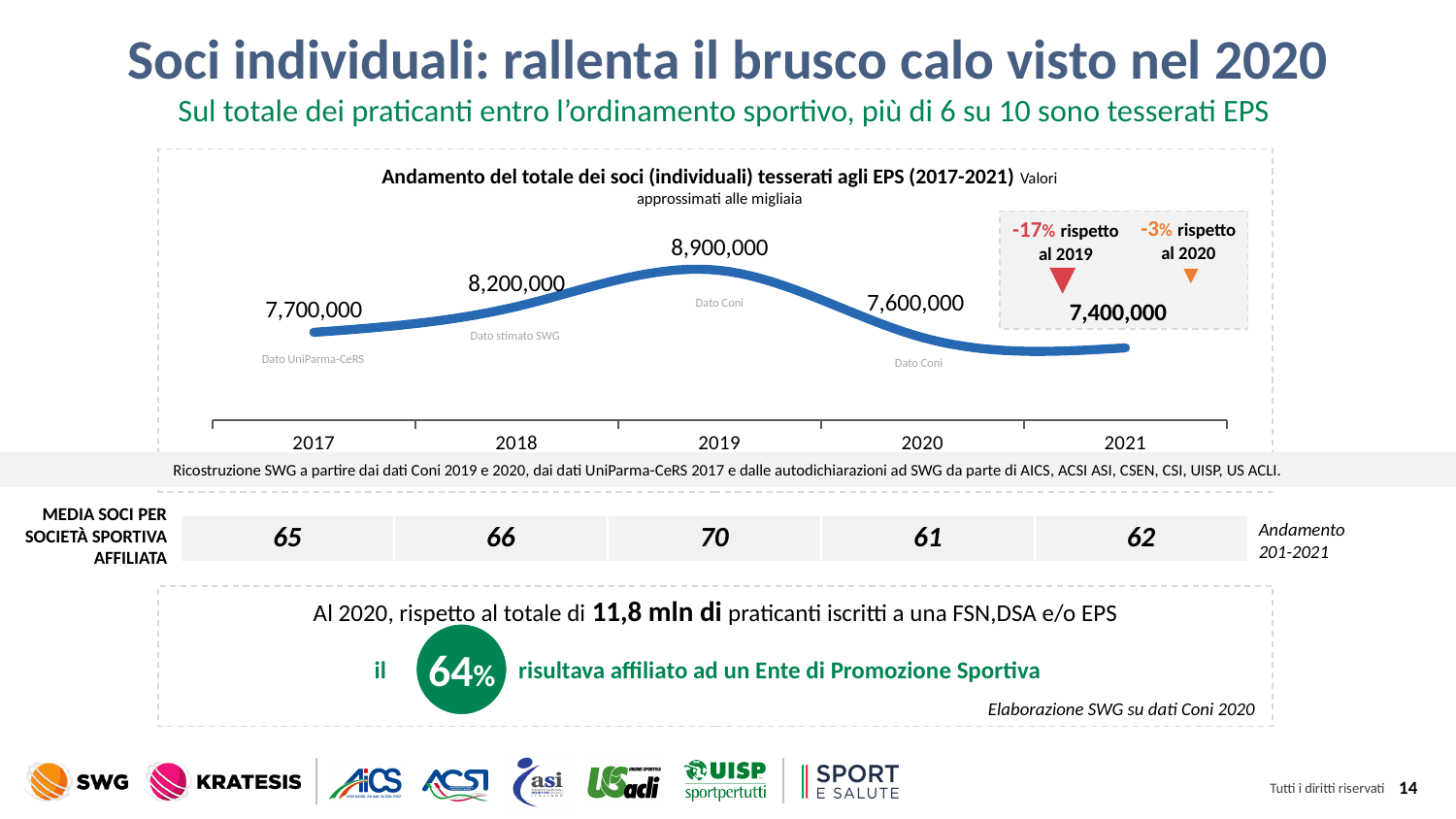
How many years are plotted in the chart of total EPS individual members? 5 According to the annotation on the chart, what is the percentage change of the 2021 value compared to 2019? -17% Do the values in the chart of total EPS individual members rise or fall from 2019 to 2021? fall What kind of chart shows the total EPS individual members from 2017 to 2021? line chart Which year has the lowest value in the chart of total EPS individual members? 2021 What is the difference between the 2019 and 2020 values in the chart of total EPS individual members? 1,300,000 What is the value for 2019 in the chart 'Andamento del totale dei soci (individuali) tesserati agli EPS (2017-2021)'? 8,900,000 What is the value for 2017 in the chart of total EPS individual members? 7,700,000 What is the difference between the 2018 and 2017 values in the chart of total EPS individual members? 500,000 What is the value for 2021 in the chart of total EPS individual members? 7,400,000 Which year has the highest value in the chart of total EPS individual members? 2019 In the chart of total EPS individual members, which year has the larger value, 2018 or 2020? 2018